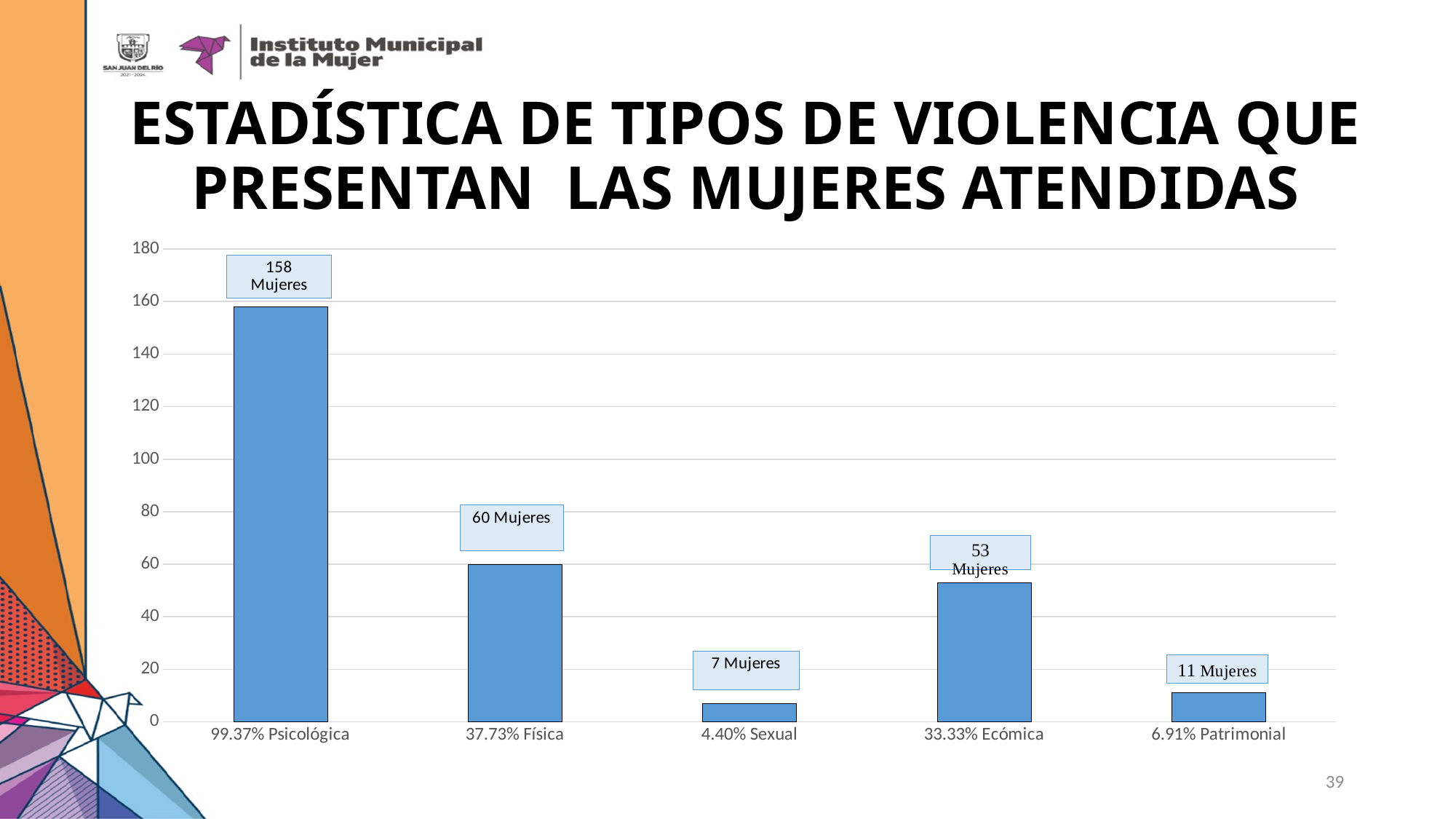
What kind of chart is shown on the slide? bar chart What is the value labelled for the Patrimonial bar? 11 Mujeres How many women are shown for the Sexual category? 7 Mujeres Is the value for Ecómica greater or less than 40? greater Which category has the lowest bar? 4.40% Sexual What is the value labelled for the Física bar? 60 Mujeres Which is larger, the value for Física or the value for Ecómica? Física How many women are shown for the Psicológica category? 158 Mujeres What percentage is shown in the x-axis label for the Patrimonial category? 6.91% How many categories are shown on the x axis? 5 What is the difference between the Psicológica value and the Física value? 98 Which category has the highest bar? 99.37% Psicológica